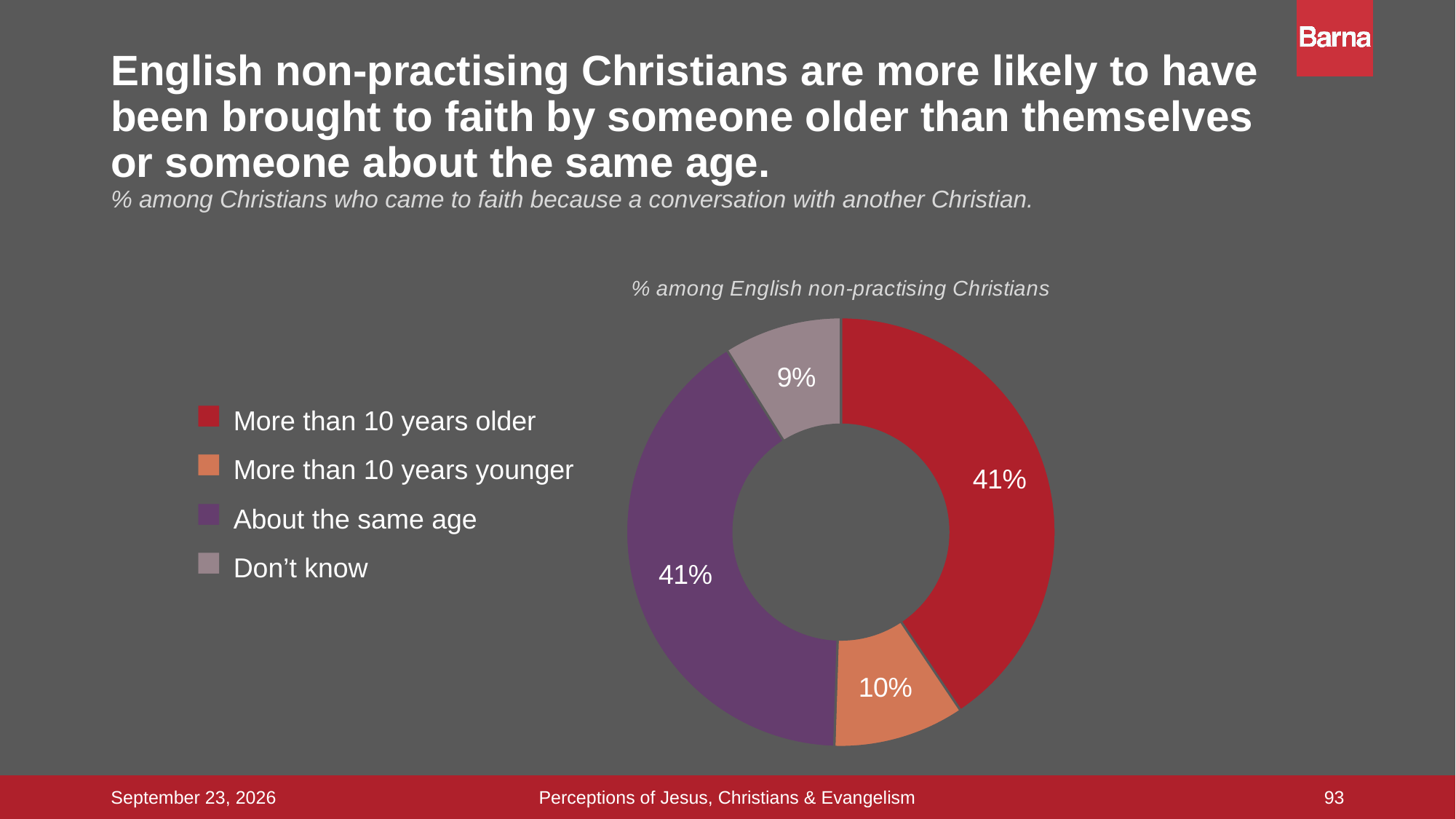
What colour represents 'About the same age' in the chart? Purple What percentage of English non-practising Christians were brought to faith by someone more than 10 years younger? 10% What is the difference between the 'About the same age' share and the 'More than 10 years younger' share? 31 percentage points Which category has the smallest share of the chart? Don't know How many categories does the chart show? 4 What percentage of English non-practising Christians were brought to faith by someone about the same age? 41% What is the combined share of 'More than 10 years older' and 'About the same age'? 82% What percentage of English non-practising Christians were brought to faith by someone more than 10 years older? 41% What kind of chart is shown on the slide? Doughnut (pie) chart What is the difference between the 'More than 10 years younger' share and the 'Don't know' share? 1 percentage point Which is larger: the share for 'More than 10 years older' or the share for 'More than 10 years younger'? More than 10 years older What percentage of English non-practising Christians answered 'Don't know'? 9%